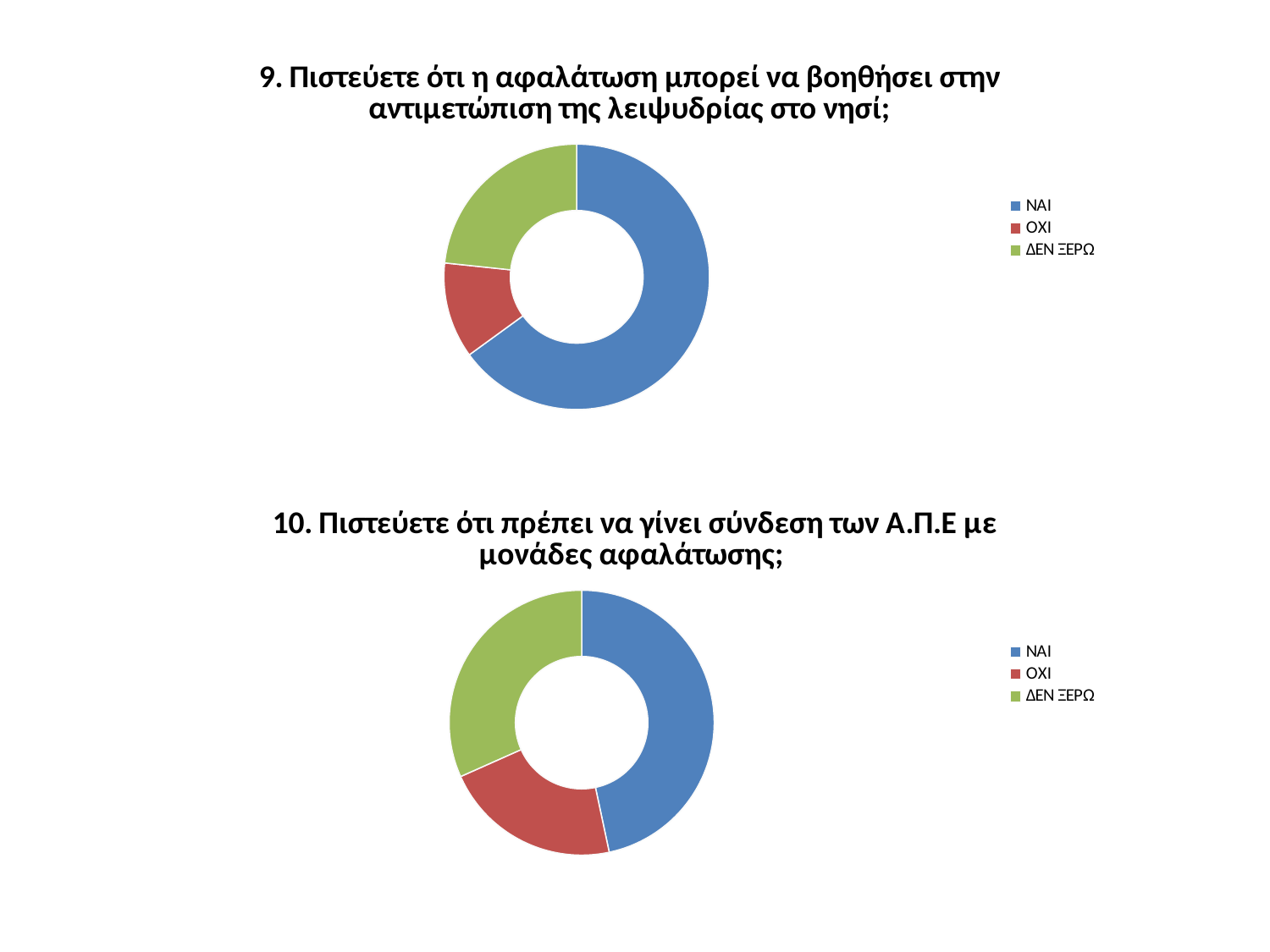
In the bottom chart (question 10), how many categories does the legend list? 3 In the top chart (question 9), what colour represents the category ΔΕΝ ΞΕΡΩ? green In the top chart (question 9), which category has the smallest share? ΟΧΙ In the top chart (question 9), how many categories does the legend list? 3 In the bottom chart (question 10), which is larger: the share for ΝΑΙ or the share for ΔΕΝ ΞΕΡΩ? ΝΑΙ In the bottom chart (question 10), which category has the smallest share? ΟΧΙ In the bottom chart (question 10), which category has the largest share? ΝΑΙ In the top chart (question 9), which category has the largest share? ΝΑΙ In the bottom chart (question 10), what colour represents the category ΟΧΙ? red What kind of chart is shown under question 10 (the bottom chart)? doughnut chart In the top chart (question 9), which is larger: the share for ΟΧΙ or the share for ΔΕΝ ΞΕΡΩ? ΔΕΝ ΞΕΡΩ What kind of chart is shown under question 9 (the top chart)? doughnut chart